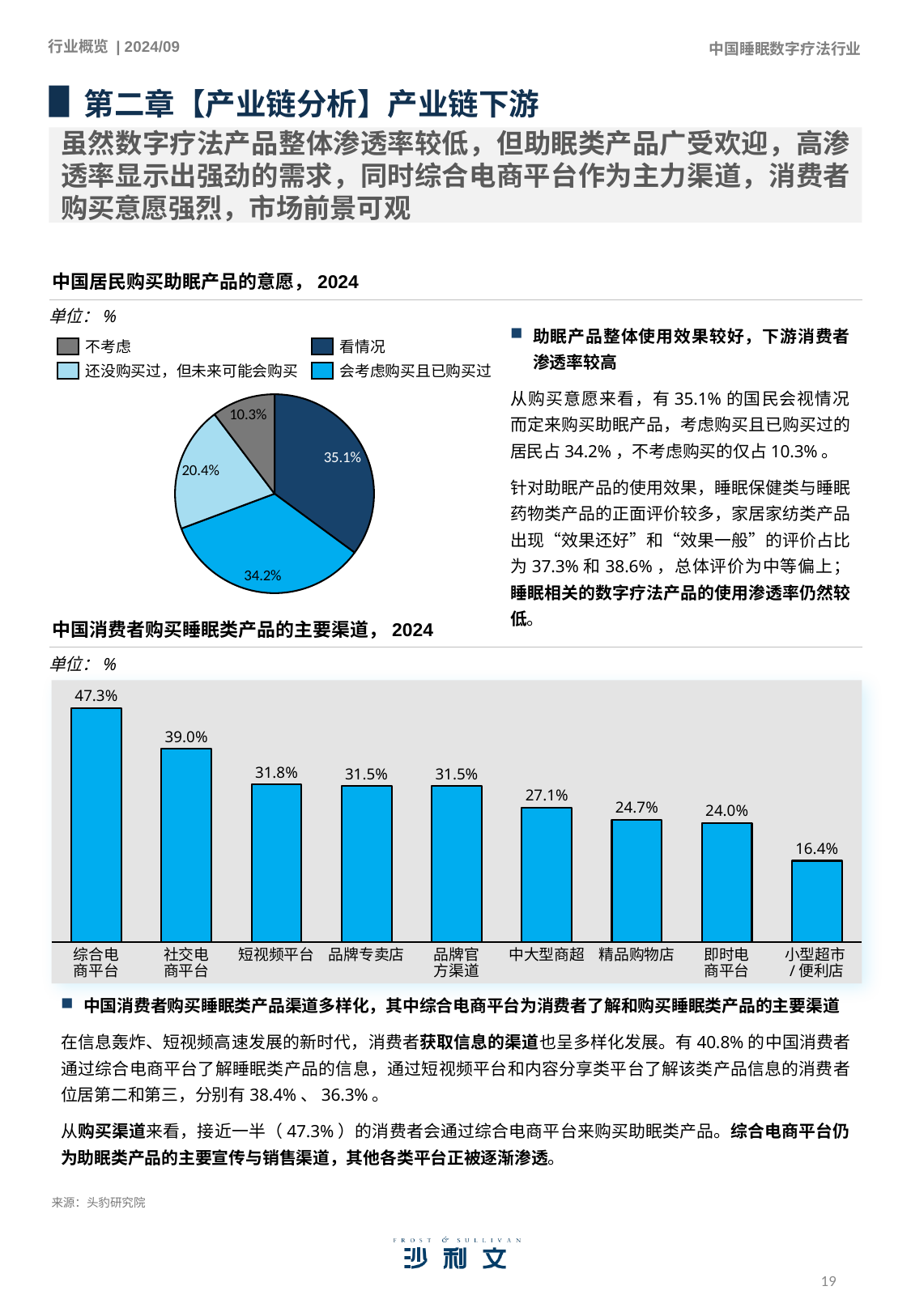
在“中国居民购买助眠产品的意愿，2024”饼图中，“会考虑购买且已购买过”与“还没购买过，但未来可能会购买”的占比相差多少？ 13.8% 在“中国居民购买助眠产品的意愿，2024”饼图中，图例列出了几个类别？ 4 在“中国消费者购买睡眠类产品的主要渠道，2024”图中，共有多少个渠道类别？ 9 在“中国消费者购买睡眠类产品的主要渠道，2024”图中，从左到右各渠道的数值呈上升还是下降趋势？ 下降 在“中国消费者购买睡眠类产品的主要渠道，2024”图中，哪个渠道的数值最低？ 小型超市/便利店 “中国消费者购买睡眠类产品的主要渠道，2024”是什么类型的图表？ 柱状图（条形图） 在“中国消费者购买睡眠类产品的主要渠道，2024”图中，“综合电商平台”与“社交电商平台”的数值相差多少？ 8.3% 在“中国居民购买助眠产品的意愿，2024”饼图中，“看情况”的占比是多少？ 35.1% 在“中国消费者购买睡眠类产品的主要渠道，2024”图中，“中大型商超”和“精品购物店”哪个数值更高？ 中大型商超 在“中国居民购买助眠产品的意愿，2024”饼图中，“不考虑”的占比是多少？ 10.3% 在“中国居民购买助眠产品的意愿，2024”饼图中，哪一类占比最大？ 看情况 在“中国消费者购买睡眠类产品的主要渠道，2024”图中，“综合电商平台”的数值是多少？ 47.3%